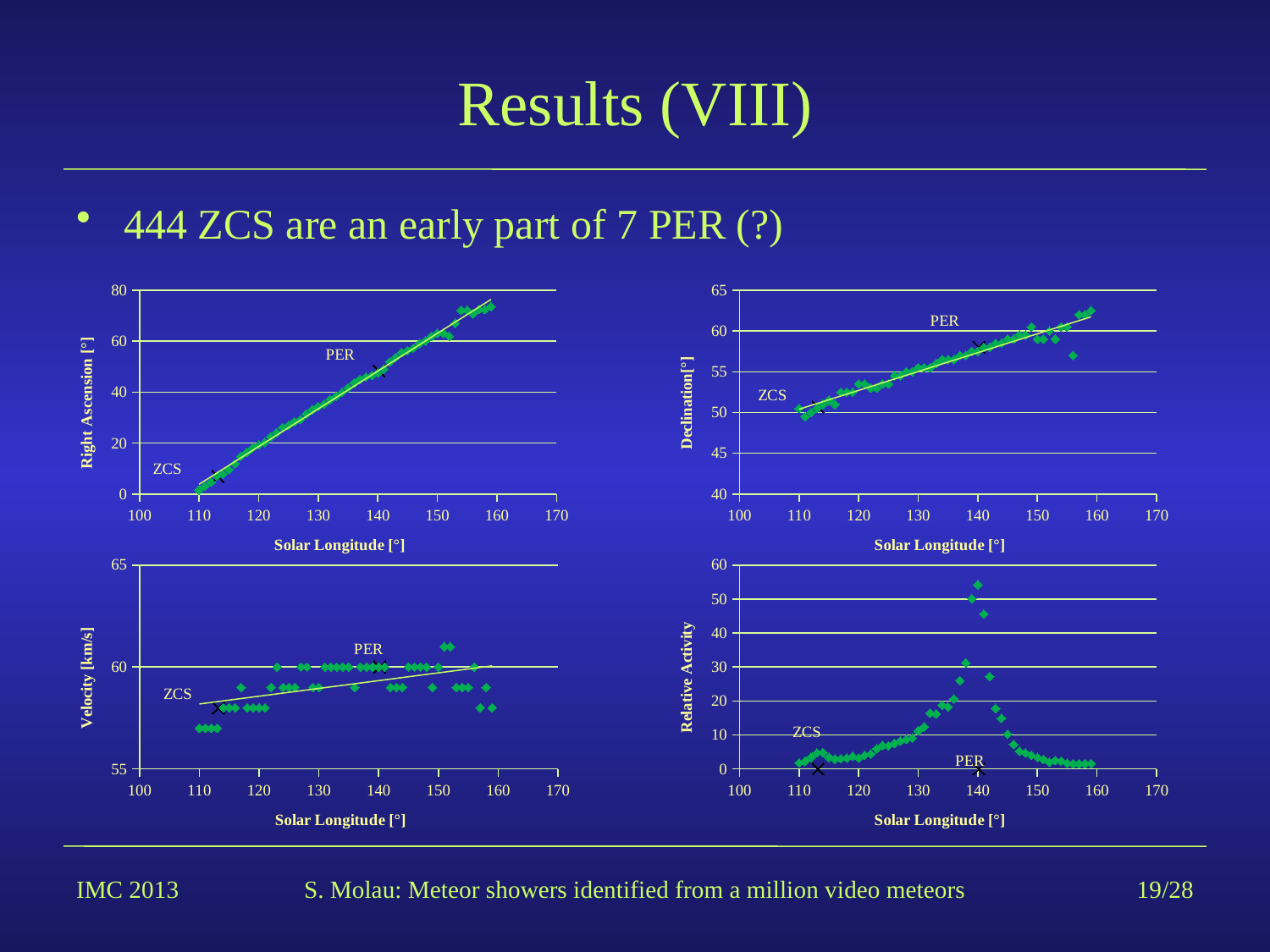
How many charts are shown on the slide? 4 In the bottom-right chart, at roughly which Solar Longitude does Relative Activity reach its peak: near 140 or near 110? near 140 What is the y-axis title of the bottom-left chart? Velocity [km/s] What kind of chart is the top-left chart (Right Ascension vs Solar Longitude)? scatter chart In the top-right chart, does Declination rise or fall as Solar Longitude increases? rise In the top-right chart, is the Declination at Solar Longitude 110 greater or less than 55? less In the bottom-right chart (Relative Activity), is the peak value greater or less than 50? greater In the top-left chart, is the Right Ascension at Solar Longitude 110 greater or less than 20? less In the top-left chart, does Right Ascension rise or fall as Solar Longitude increases from 110 to 160? rise What is the x-axis title shared by all four charts? Solar Longitude [°]